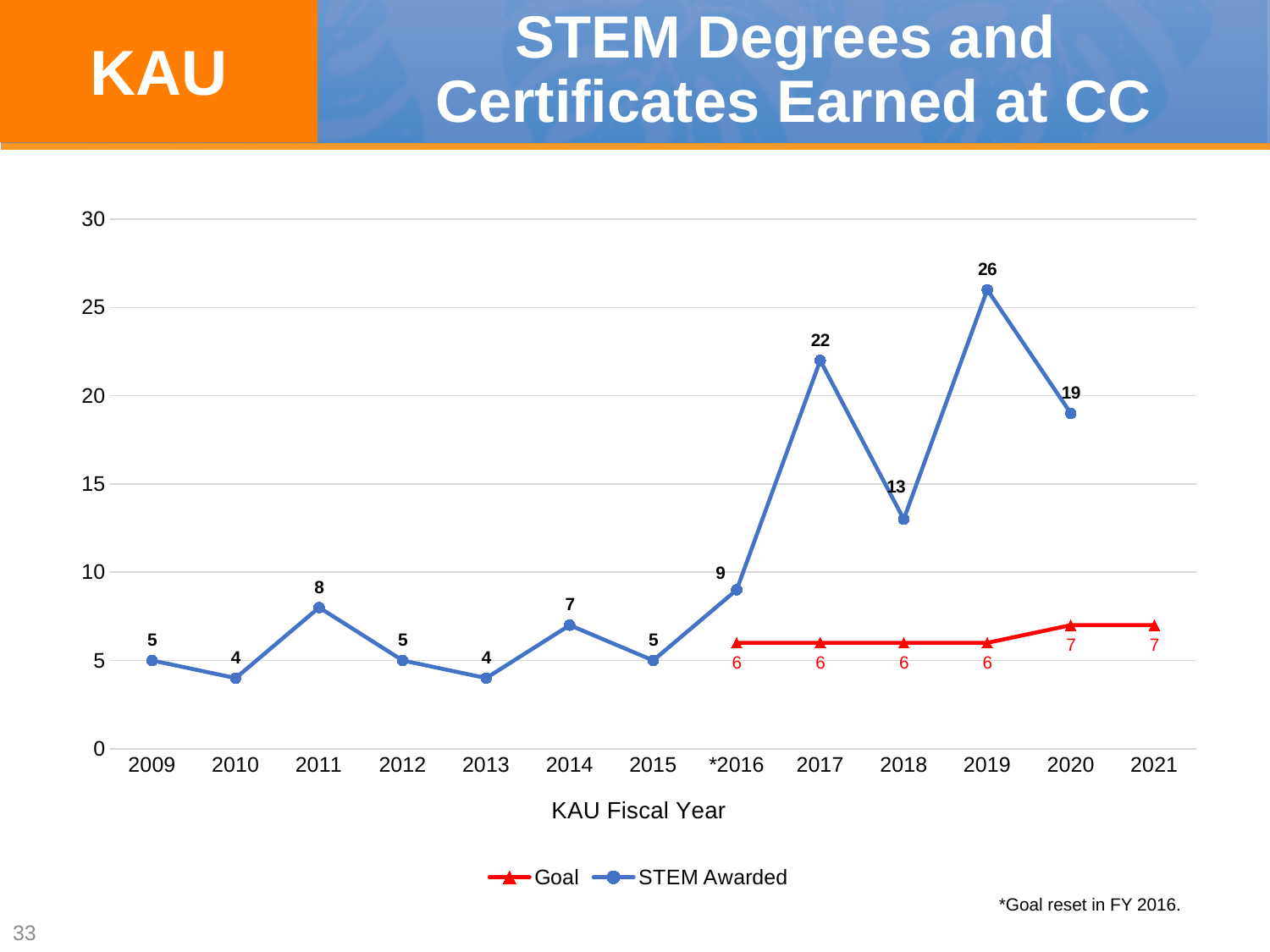
What kind of chart is shown on the slide? line chart In which year does the Goal series first appear? *2016 What is the x-axis title of the chart? KAU Fiscal Year Does the STEM Awarded value rise or fall from 2019 to 2020? fall What is the STEM Awarded value for 2019? 26 What is the difference between the STEM Awarded values for 2017 and 2018? 9 How many years are shown on the x axis? 13 What is the STEM Awarded value for 2011? 8 Which is larger, the STEM Awarded value for 2020 or for 2018? 2020 What is the Goal value for 2020? 7 Which year has the highest STEM Awarded value? 2019 How many series does the legend list? 2